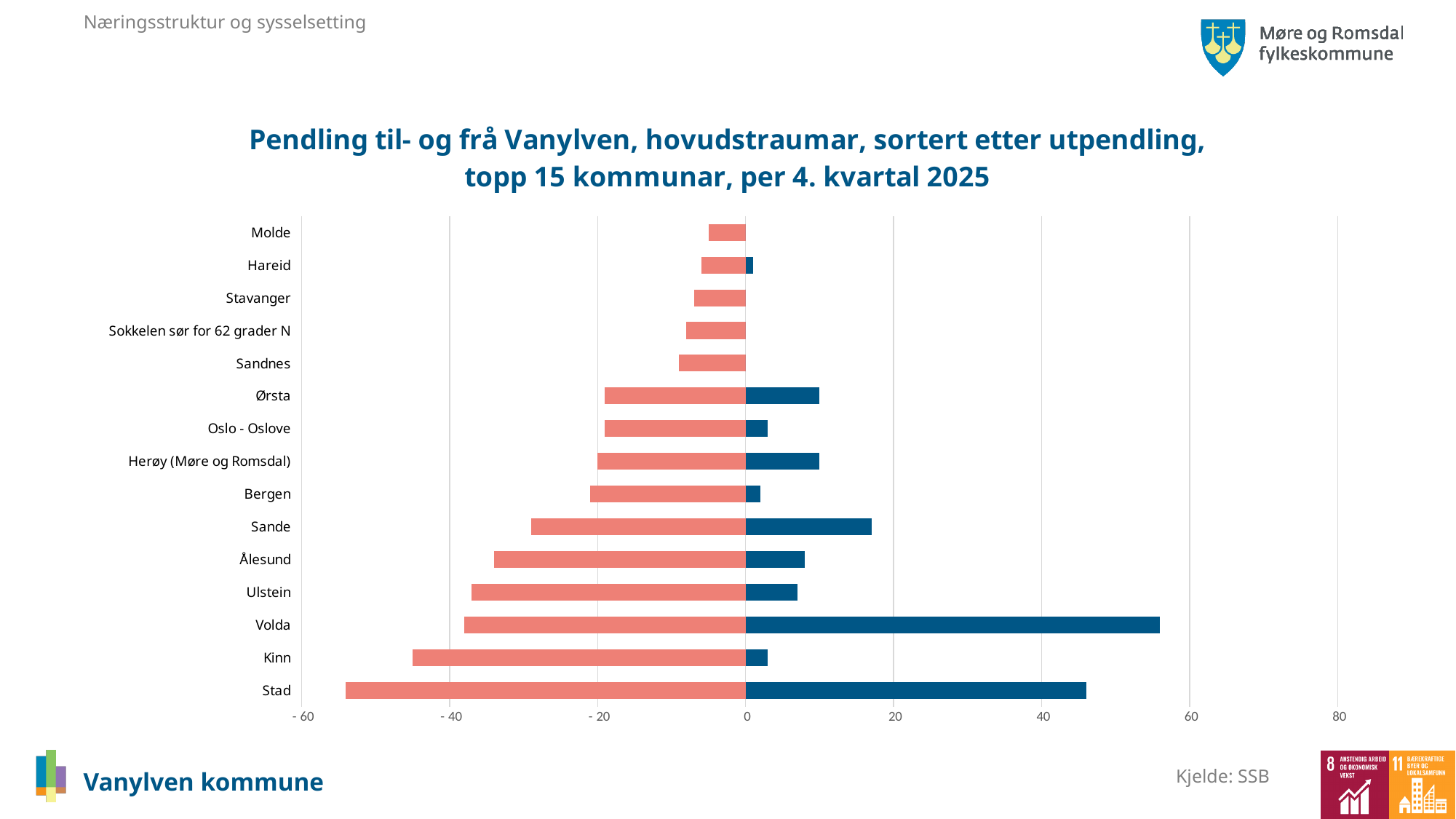
Is the red bar value for Kinn greater or less than -40? less Is the blue bar value for Stad greater or less than 40? greater What kind of chart is shown on the slide? bar chart How many municipalities (categories) are listed on the chart? 15 Which has the larger blue bar, Sande or Ålesund? Sande Is the blue bar value for Sande greater or less than 20? less Which municipality has the longest blue bar (largest positive value)? Volda Which municipality has the longest red bar (extending furthest to the left)? Stad What source is cited for the chart data? SSB Which has the longer red bar, Stad or Kinn? Stad